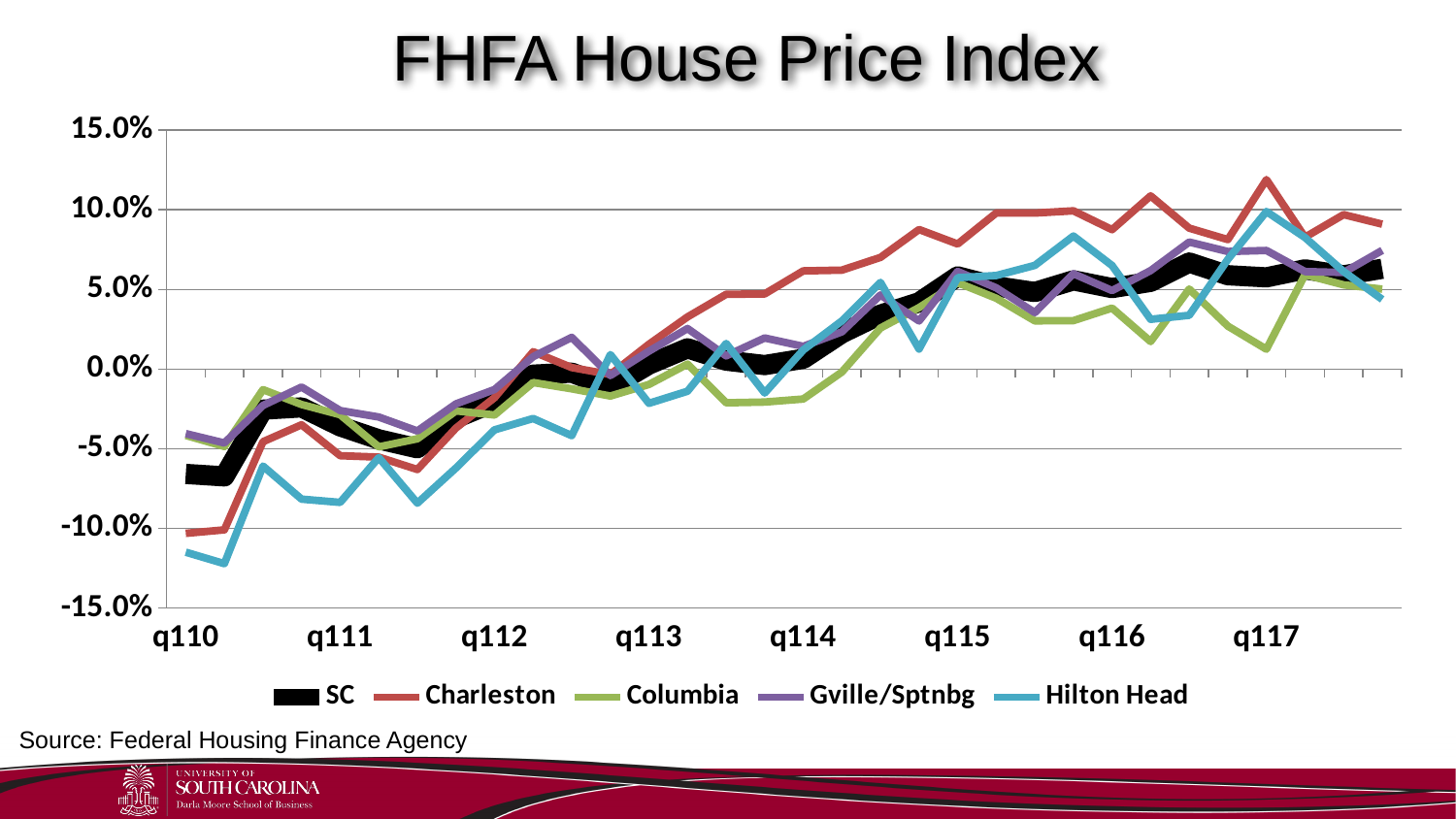
How many series does the legend list? 5 Which series is drawn as the thick black line? SC Is the value for Hilton Head at q110 greater or less than -10.0%? less What kind of chart is shown on the slide? line chart How many quarter labels are shown on the x axis? 8 Which series has the highest value at q117? Charleston Which series has the lowest value at q110? Hilton Head Is the value for Charleston at q117 greater or less than 10.0%? greater What is the title of the chart? FHFA House Price Index Is the value for SC at q110 greater or less than -5.0%? less At q110, which is higher, SC or Charleston? SC